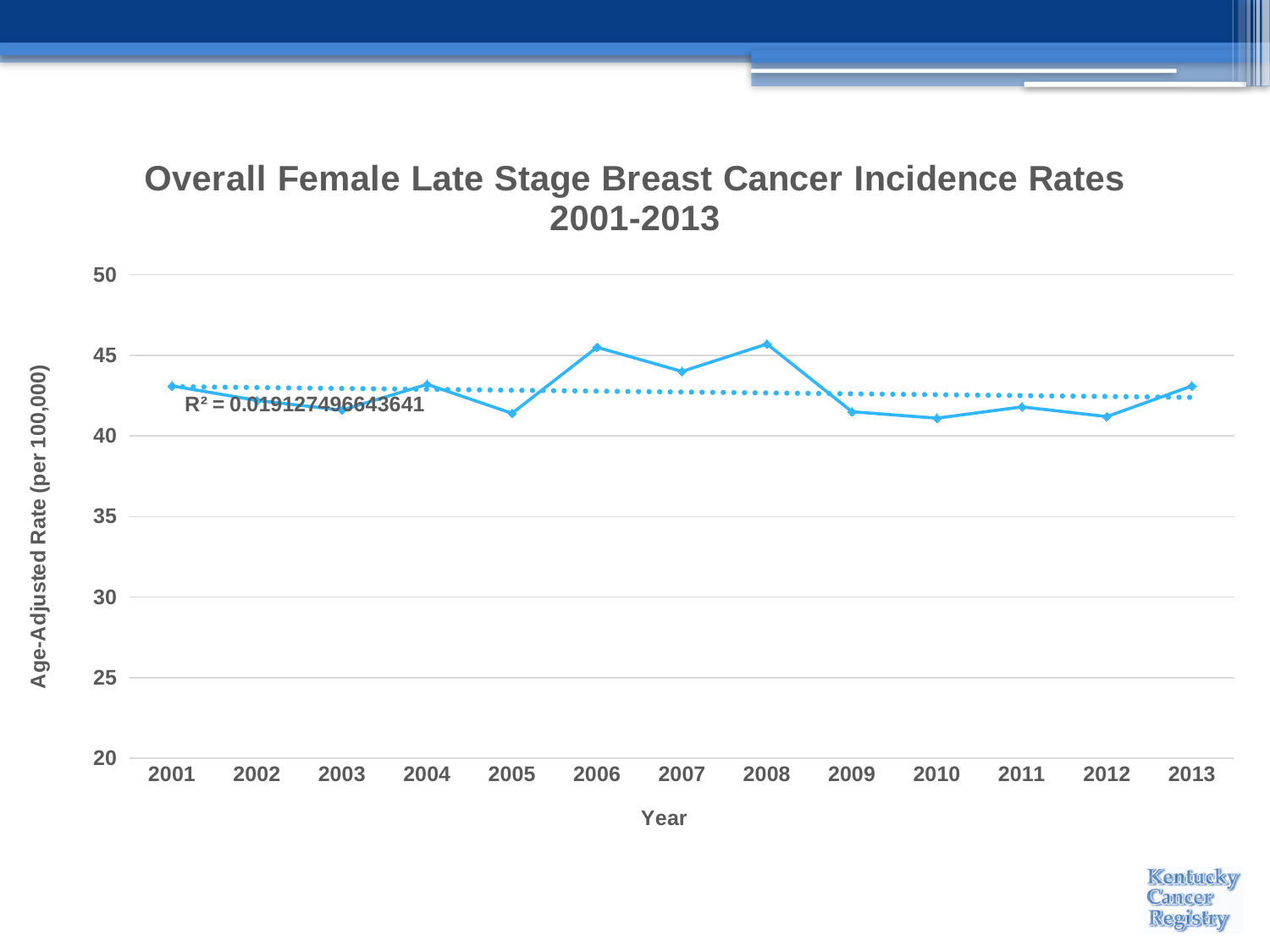
Is the value for 2005 greater or less than 45? less What kind of chart is shown on the slide? line chart What is the title of the chart? Overall Female Late Stage Breast Cancer Incidence Rates 2001-2013 Which year has the larger value, 2008 or 2009? 2008 Do the values rise or fall from 2005 to 2006? rise How many years are plotted along the x axis? 13 Which year has the larger value, 2005 or 2006? 2006 Is the value for 2001 greater or less than 45? less What is the label on the vertical axis of the chart? Age-Adjusted Rate (per 100,000) Is the value for 2010 greater or less than 40? greater Do the values rise or fall from 2008 to 2010? fall